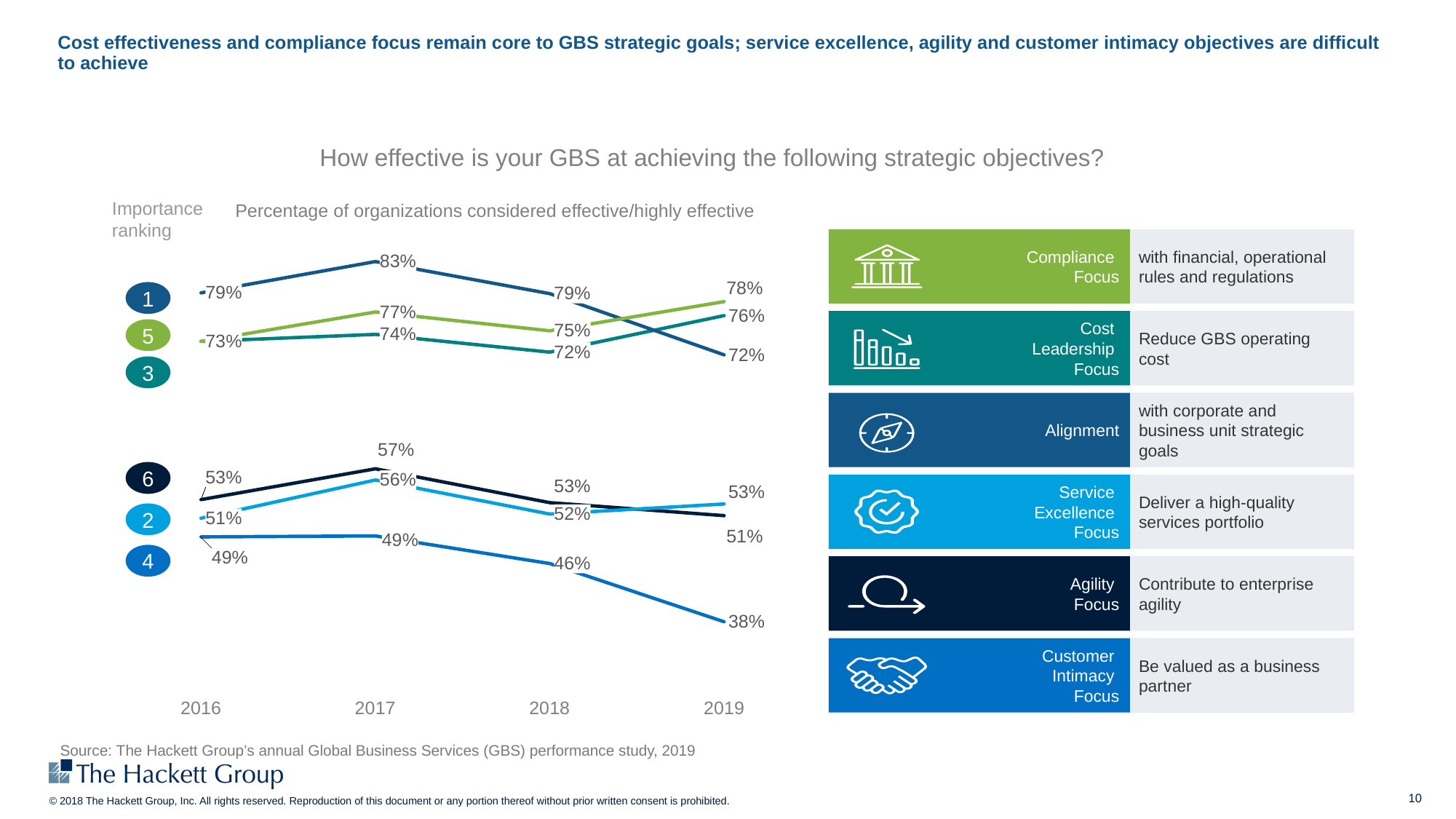
What is the value for Customer Intimacy Focus in 2019? 38% What is the value for Compliance Focus in 2019? 78% Which strategic objective has the highest value in 2019? Compliance Focus What kind of chart is shown on the slide? line chart How many years are shown on the x axis of the chart? 4 What is the difference between the Alignment value in 2017 and in 2019? 11 percentage points Which is larger in 2019, the value for Agility Focus or the value for Customer Intimacy Focus? Agility Focus Which strategic objective has the lowest value in 2019? Customer Intimacy Focus Does the Customer Intimacy Focus line rise or fall from 2017 to 2019? fall What is the value for Alignment in 2017? 83% What is the value for Cost Leadership Focus in 2018? 72% What importance ranking is shown next to the Compliance Focus line? 5